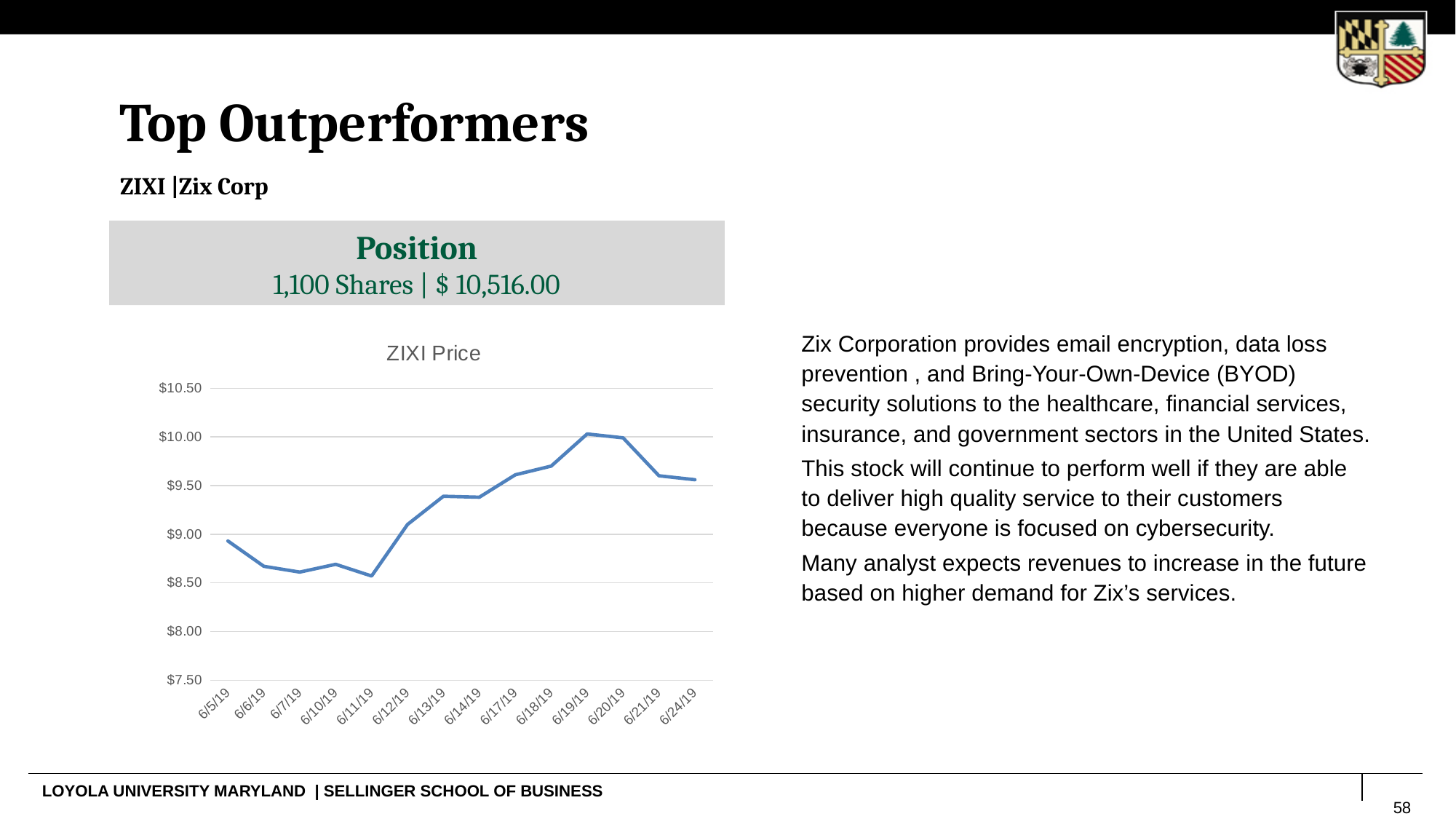
Is the value for 6/17/19 greater or less than $9.00? greater What is the highest value shown on the y axis of the chart? $10.50 How many dates are plotted along the x axis of the ZIXI Price chart? 14 Is the value for 6/11/19 greater or less than $9.00? less What kind of chart is shown on the slide? line chart Is the value for 6/19/19 greater or less than $9.50? greater Overall, does the ZIXI price rise or fall from 6/5/19 to 6/24/19? rise Which is lower, the value for 6/11/19 or the value for 6/18/19? 6/11/19 Which is higher, the value for 6/19/19 or the value for 6/5/19? 6/19/19 What is the title of the chart? ZIXI Price